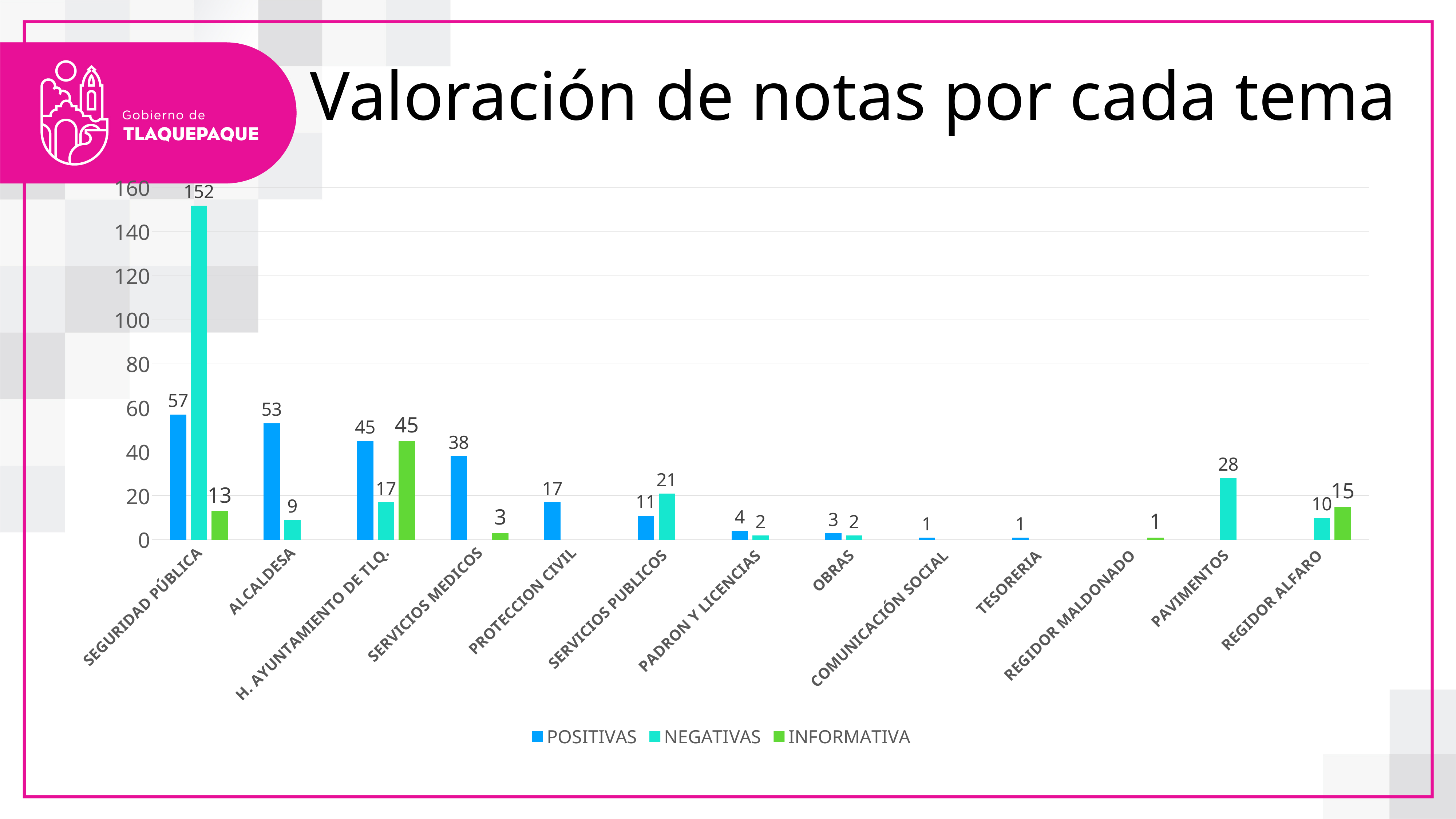
What is the INFORMATIVA value for H. AYUNTAMIENTO DE TLQ.? 45 How many series does the legend list? 3 Is the NEGATIVAS value for SEGURIDAD PÚBLICA greater or less than 140? greater What kind of chart is shown on the slide? bar chart What is the title of the chart? Valoración de notas por cada tema Which category has the highest POSITIVAS value? SEGURIDAD PÚBLICA How many categories are shown on the x axis? 13 What is the POSITIVAS value for ALCALDESA? 53 What is the NEGATIVAS value for PAVIMENTOS? 28 Which is larger: the NEGATIVAS value for REGIDOR ALFARO or its INFORMATIVA value? INFORMATIVA What is the NEGATIVAS value for SEGURIDAD PÚBLICA? 152 What is the difference between the POSITIVAS and NEGATIVAS values for SERVICIOS PUBLICOS? 10